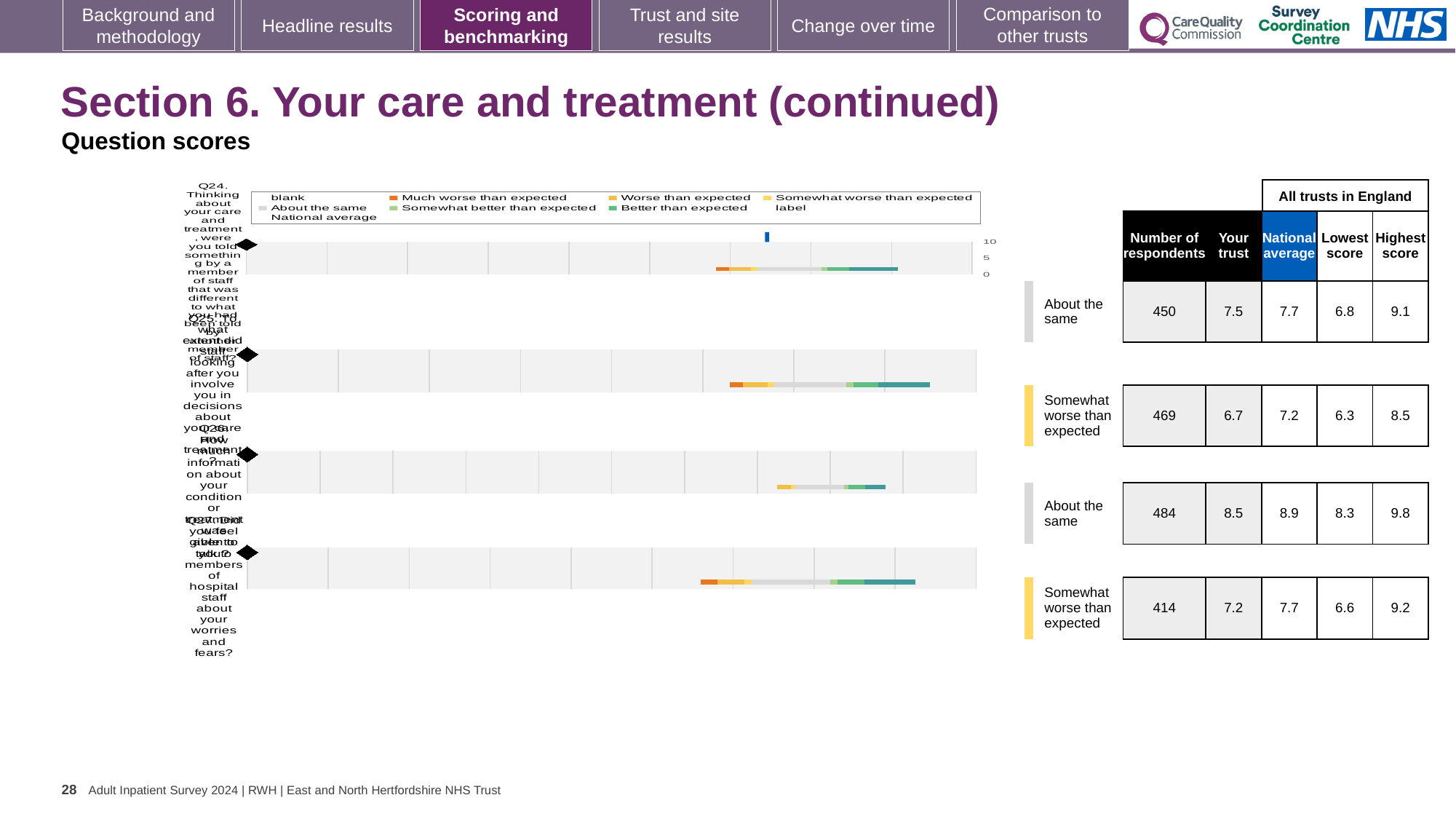
What kind of chart is shown on the slide? bar chart What is the highest score among all trusts in England for Q26? 9.8 How many respondents answered Q27? 414 What benchmark category is Q25 rated as? Somewhat worse than expected What is the national average score for Q25? 7.2 How many questions (rows) are plotted in the chart? 4 What is the title of the slide containing the chart? Section 6. Your care and treatment (continued) Which question has the highest number of respondents? Q26 What is the 'Your trust' score for Q26? 8.5 Which question has the lowest 'Your trust' score? Q25 Which has the higher 'Your trust' score, Q26 or Q24? Q26 What is the difference between the national average and the trust score for Q24? 0.2